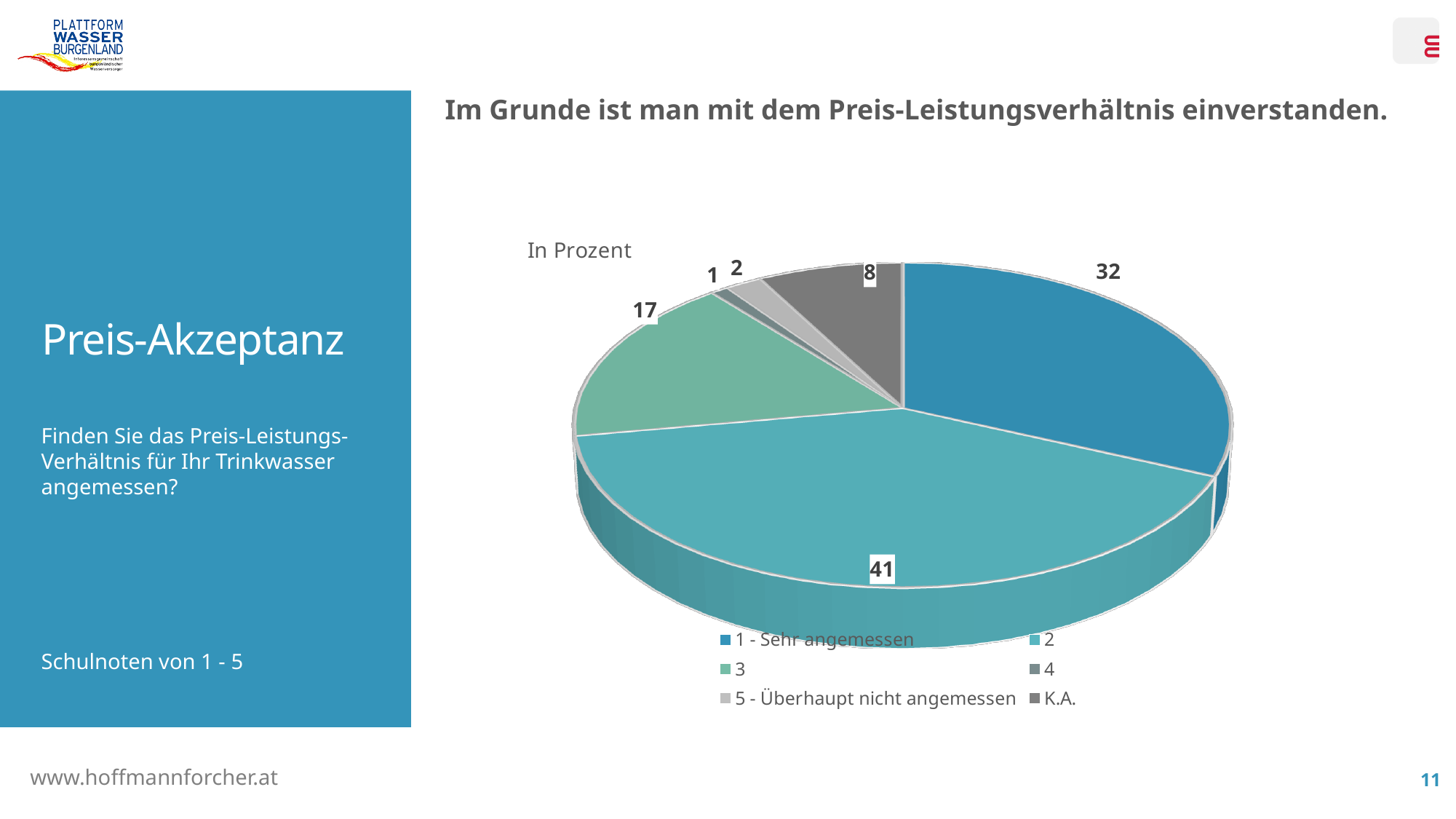
What unit label is shown above the pie chart? In Prozent What is the value for category "3"? 17 Which category has the largest slice of the pie? 2 How many slices does the pie chart have? 6 Which is larger, the value for "3" or the value for "K.A."? 3 What is the value for category "2"? 41 How many entries does the legend list? 6 What is the difference between the values for "2" and "1 - Sehr angemessen"? 9 Which category has the smallest slice of the pie? 4 What kind of chart is shown on the slide? pie chart What is the value for "K.A."? 8 What is the value for "1 - Sehr angemessen"? 32